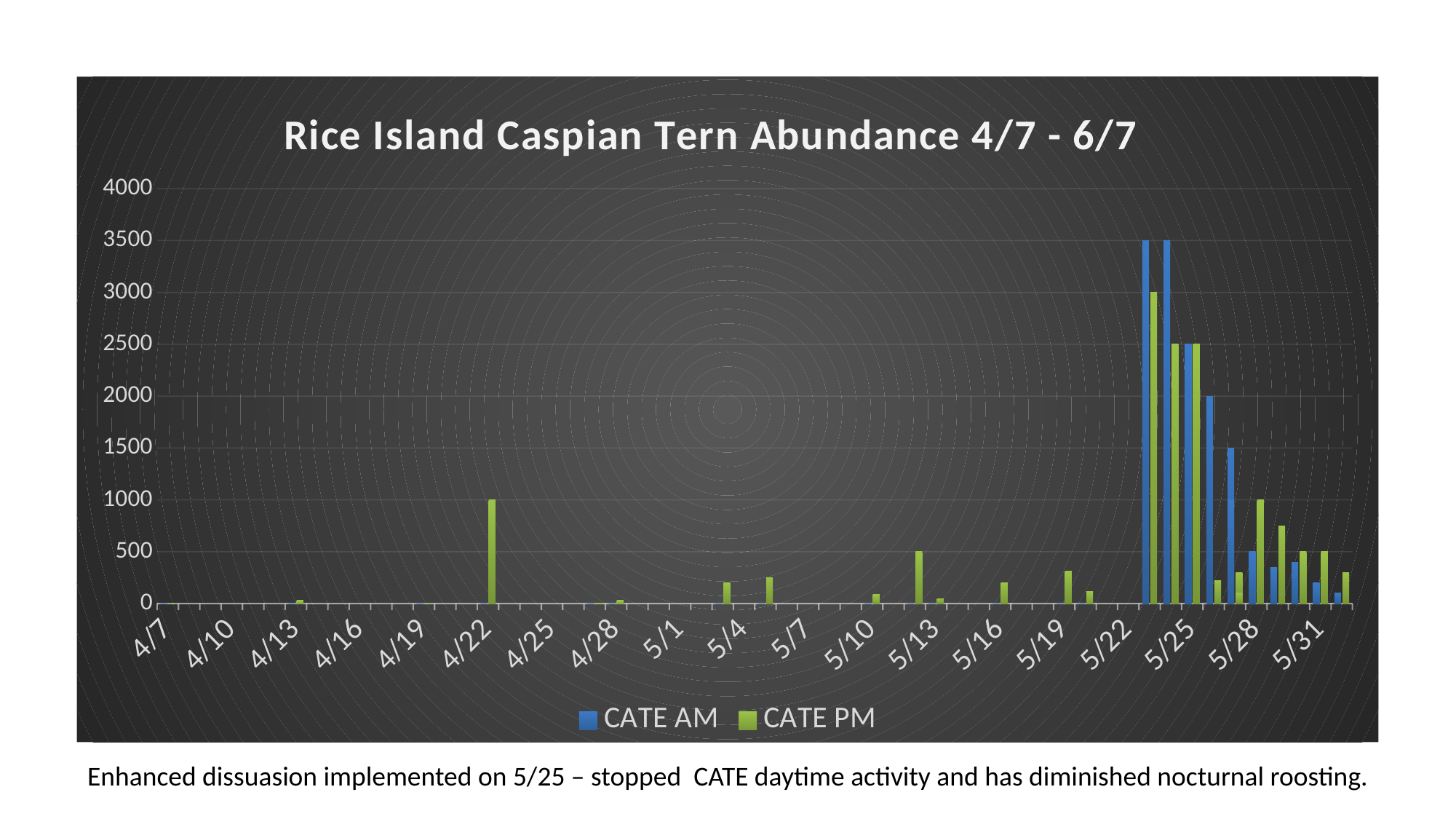
Which is larger, the tallest CATE AM bar or the tallest CATE PM bar? the tallest CATE AM bar How many series does the legend list? 2 Which colour represents the CATE PM series in the chart? green What value does the tallest CATE PM bar reach? 3000 Is the tallest bar in the chart greater or less than 3000? greater What value does the tallest CATE AM bar reach? 3500 What kind of chart is shown on the slide? bar chart Are the bars generally higher before 5/22 or after 5/22? after 5/22 What is the difference between the tallest CATE AM bar and the tallest CATE PM bar? 500 Is the CATE PM bar near 5/13 greater or less than 1000? less What is the title of the chart? Rice Island Caspian Tern Abundance 4/7 - 6/7 Which series contains the tallest bar in the chart? CATE AM